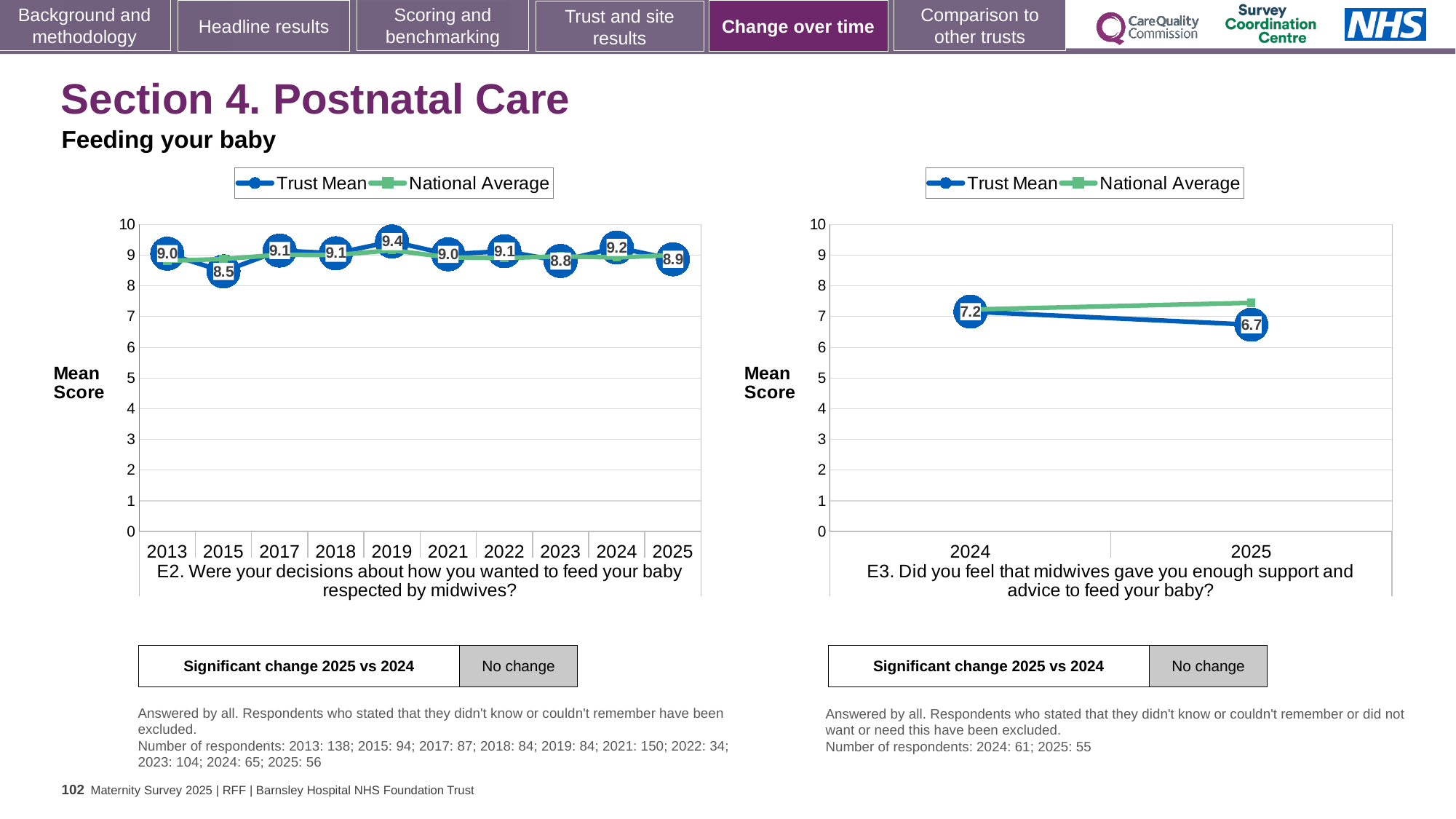
In the left chart (E2), which year has the lowest Trust Mean? 2015 In the left chart (E2), what is the Trust Mean for 2015? 8.5 In the right chart (E3), what is the difference between the Trust Mean for 2024 and 2025? 0.5 In the left chart (E2), what is the difference between the Trust Mean for 2024 and 2025? 0.3 In the right chart (E3), is the National Average for 2025 greater or less than 7? greater How many series does the legend of the right chart (E3) list? 2 In the left chart (E2), which year has the highest Trust Mean? 2019 In the left chart (E2), how many years are plotted on the x axis? 10 In the right chart (E3), does the Trust Mean rise or fall from 2024 to 2025? fall In the right chart (E3), what is the Trust Mean for 2025? 6.7 In the left chart (E2), what is the Trust Mean for 2019? 9.4 What kind of chart is the left chart (E2)? line chart